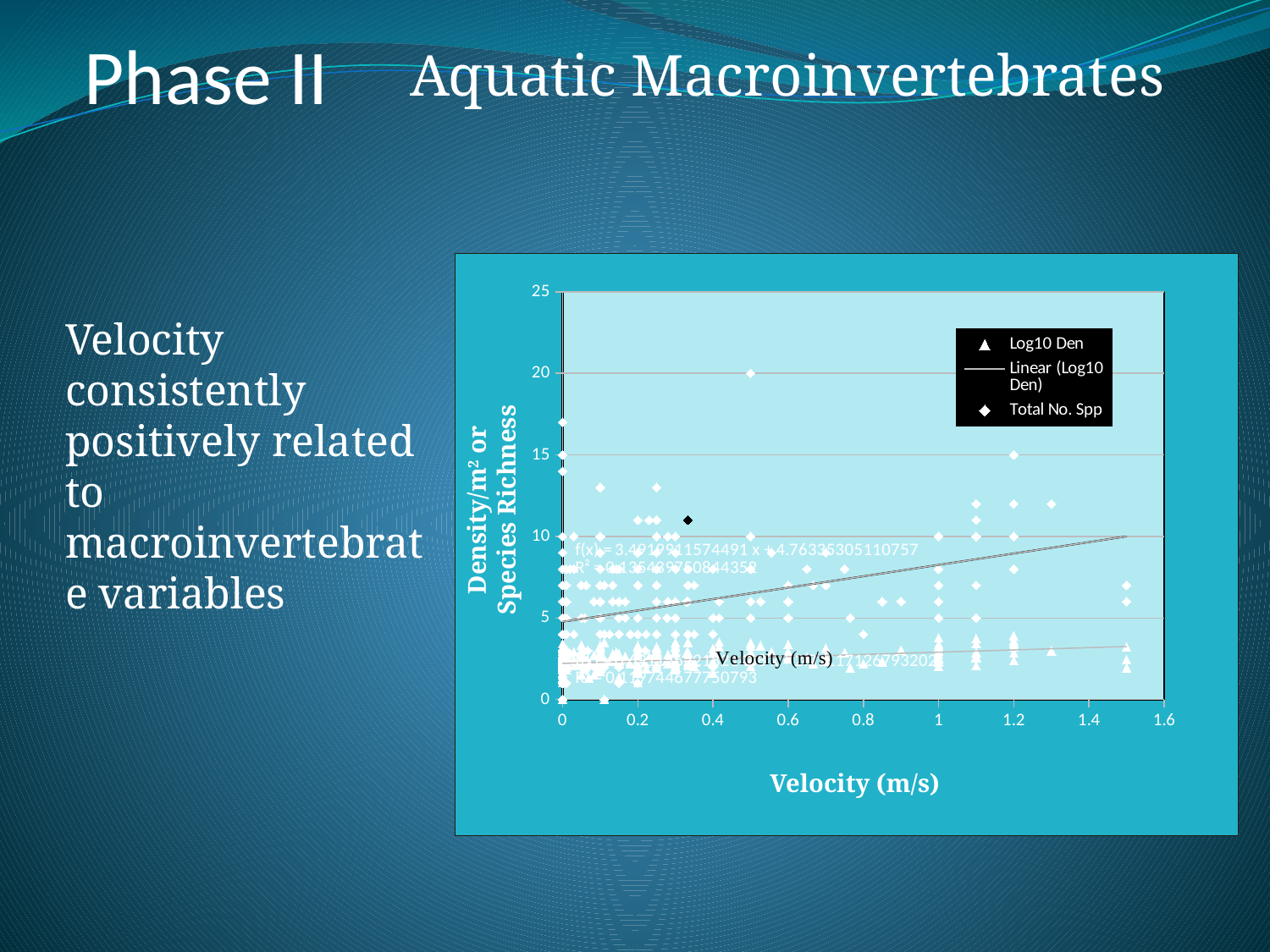
What is the highest value shown on the x axis? 1.6 What is the title of the x axis of the chart? Velocity (m/s) How many entries does the chart legend list? 3 Does the linear trendline for Log10 Den rise or fall as velocity increases? rise Which series in the legend is plotted with triangle markers? Log10 Den What kind of chart is shown on the slide? scatter chart Which series in the legend is plotted with diamond markers? Total No. Spp Are the Log10 Den values greater or less than 5? less What is the title of the y axis of the chart? Density/m² or Species Richness What is the highest value shown on the y axis? 25 How many tick labels are shown on the x axis? 9 Is the highest Total No. Spp point (at velocity 0.5) greater or less than 15? greater